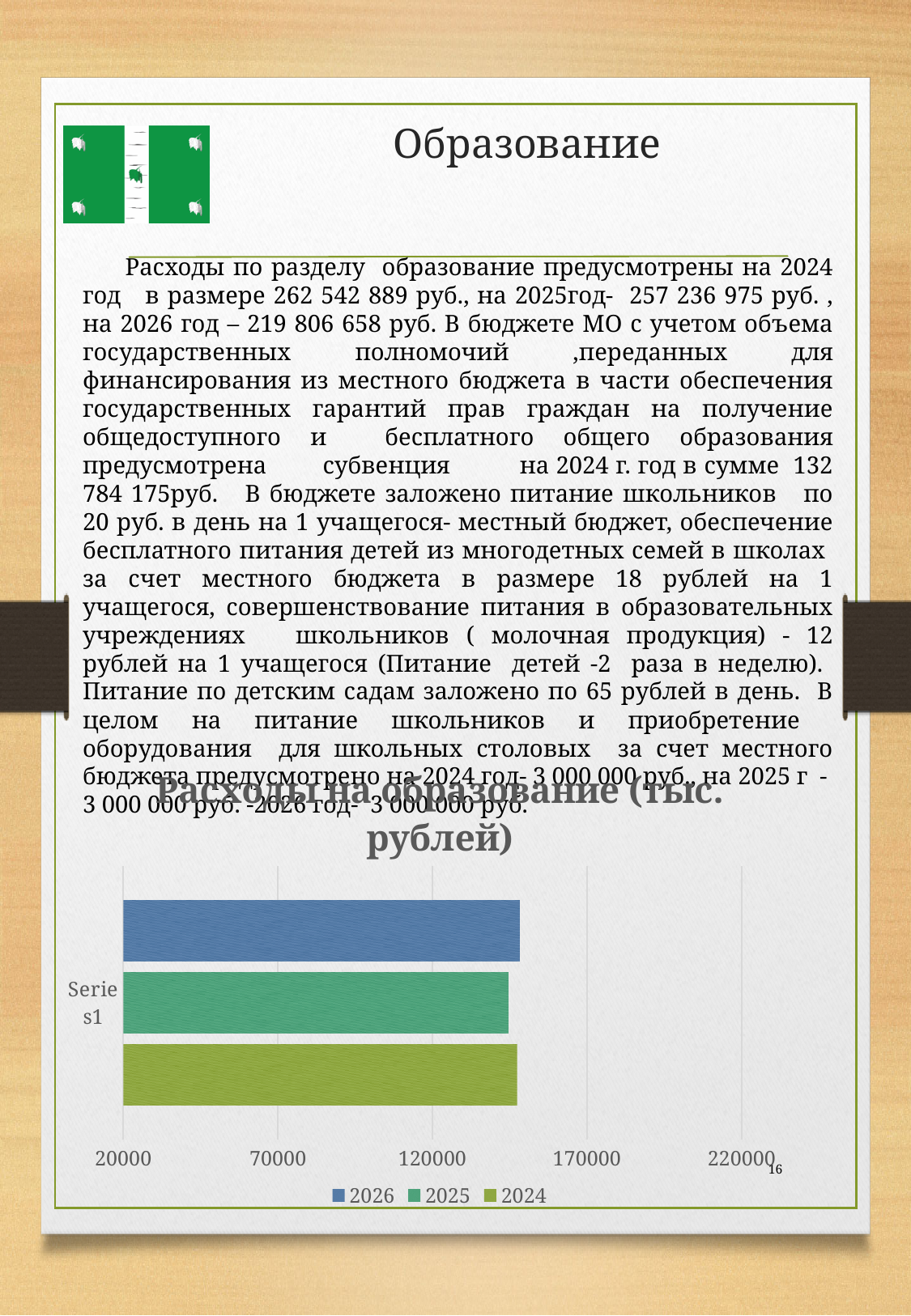
Is the value for 2024 greater or less than 70000? greater Is the value for 2025 greater or less than 170000? less How many series does the chart legend list? 3 Which years are listed in the chart legend? 2026, 2025, 2024 What kind of chart is shown on the slide? bar chart Is the value for 2024 greater or less than 120000? greater How many categories are shown on the vertical axis of the chart? 1 What is the highest value shown on the horizontal axis of the chart? 220000 What is the title of the chart? Расходы на образование (тыс. рублей)